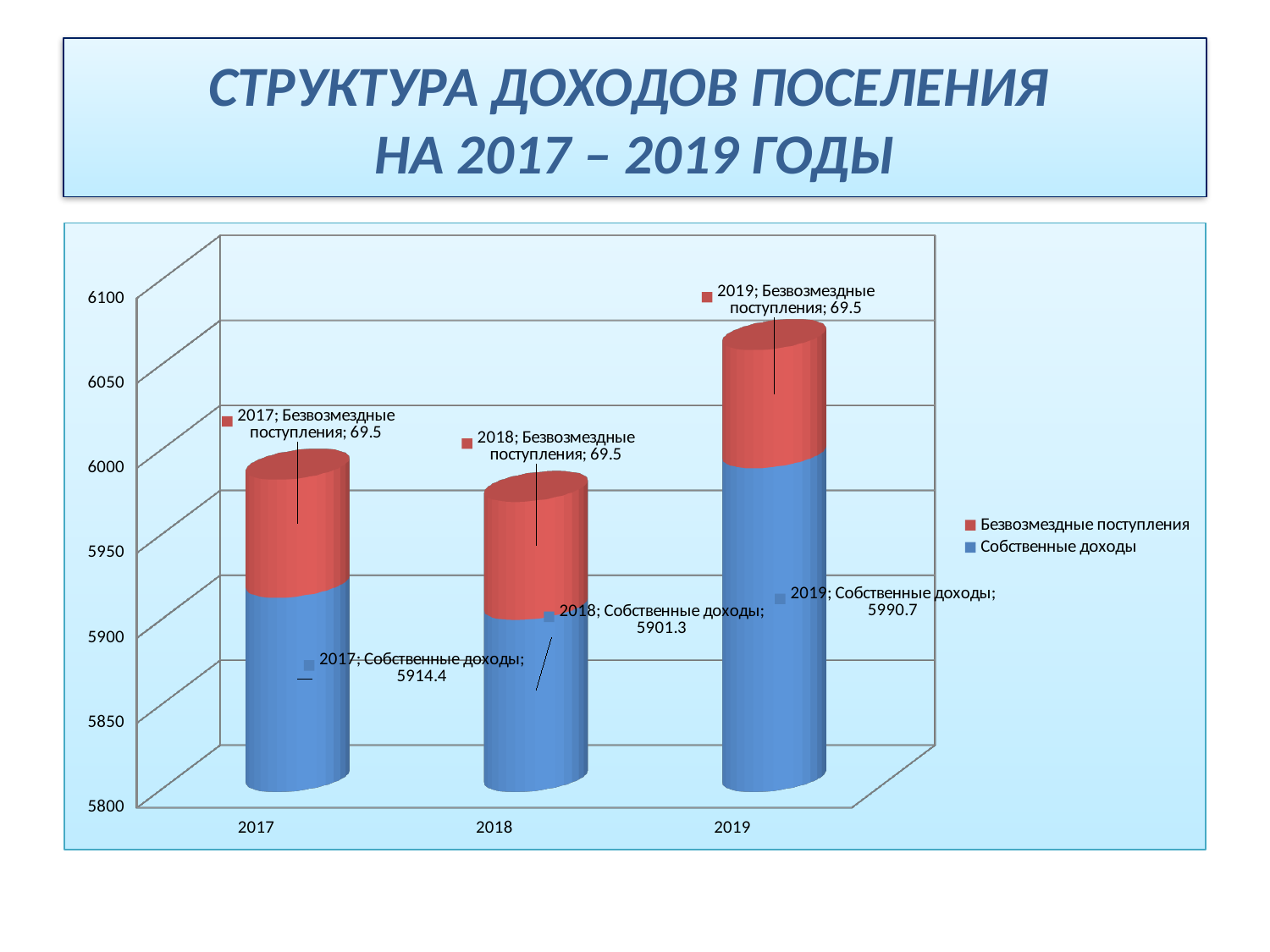
What kind of chart is shown on the slide? Stacked bar chart What is the total of the stacked bar for 2019? 6060.2 What is the difference between Собственные доходы in 2019 and in 2018? 89.4 Which year has the highest value of Собственные доходы? 2019 How many years are shown on the x axis? 3 What is the value of Собственные доходы for 2018? 5901.3 What is the value of Собственные доходы for 2019? 5990.7 What is the value of Собственные доходы for 2017? 5914.4 Which is larger, Собственные доходы in 2017 or in 2018? 2017 Which year has the lowest value of Собственные доходы? 2018 How many series does the legend list? 2 What is the value of Безвозмездные поступления for 2019? 69.5